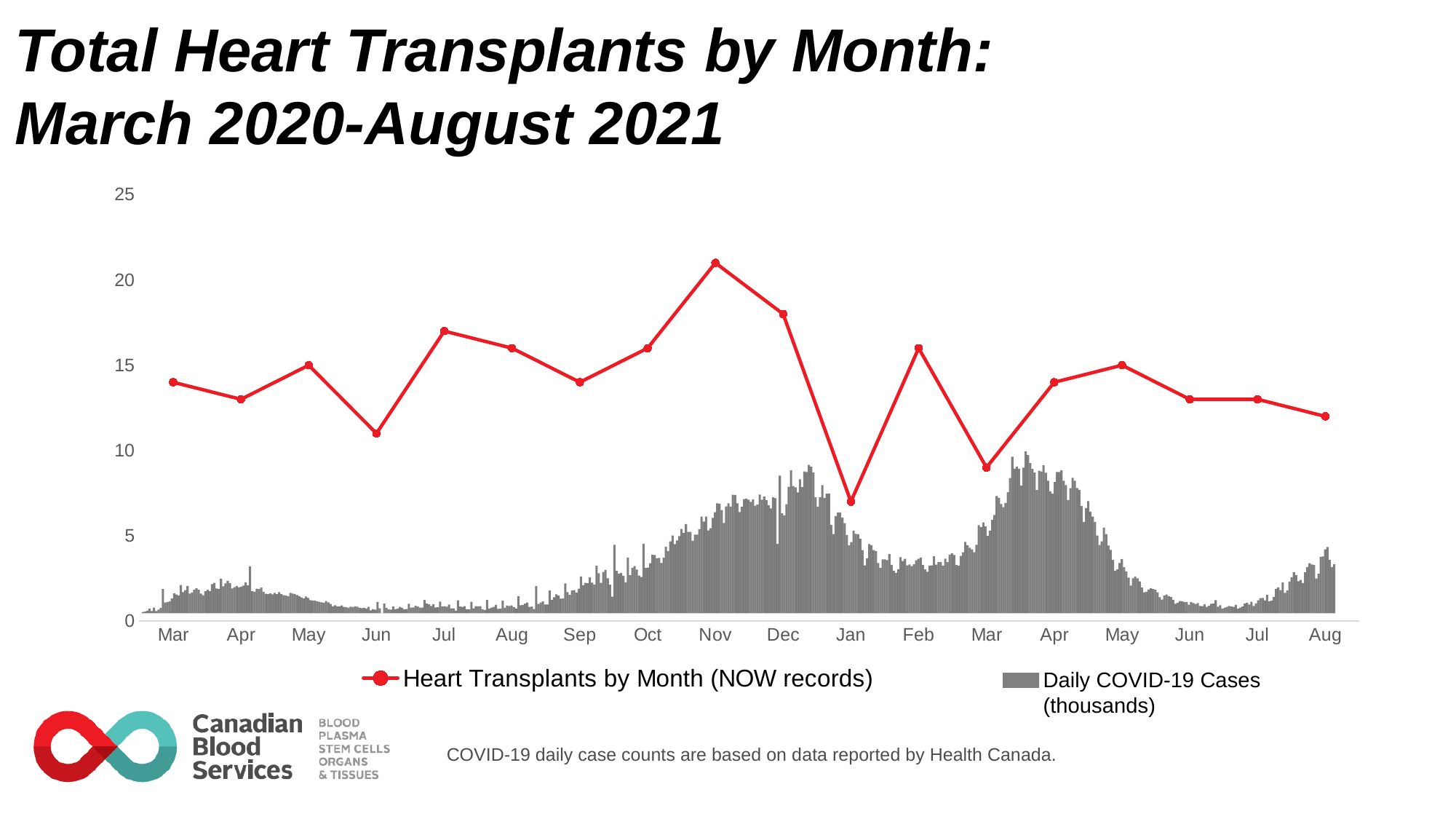
How many series does the legend list? 2 Is the heart transplant value for Nov greater or less than 20? greater How many months are shown on the x axis? 18 Is the heart transplant value for the second Mar (2021) greater or less than 10? less Which month has more heart transplants, Nov or Jan? Nov Which month has the lowest number of heart transplants on the line? Jan Is the heart transplant value for Jan greater or less than 10? less Do heart transplants rise or fall from Nov to Jan? fall Which month has the highest number of heart transplants on the line? Nov Which month has more heart transplants, the first Jul (2020) or the first Jun (2020)? Jul